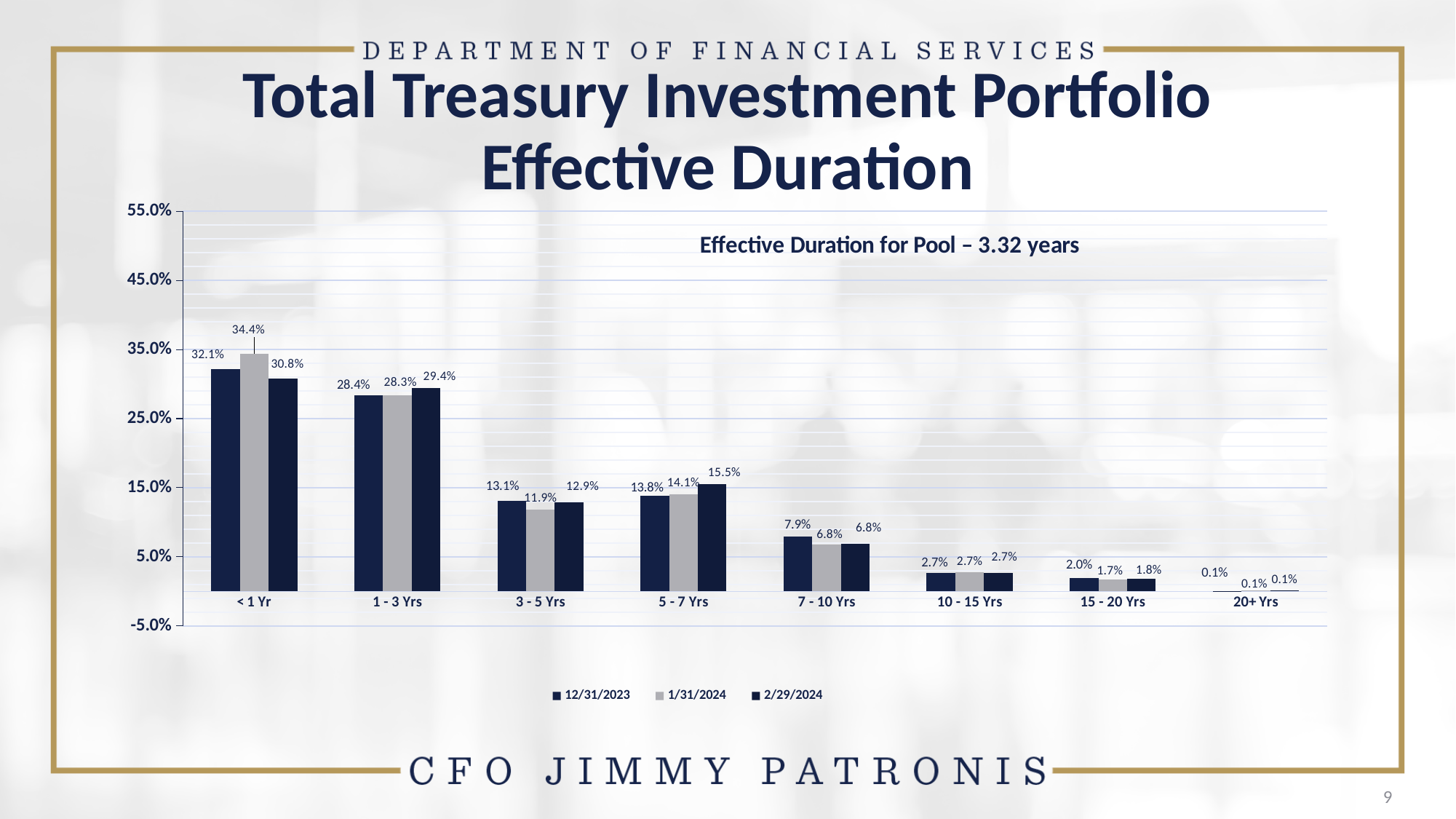
What effective duration for the pool is stated on the chart? 3.32 years What is the difference between the 1/31/2024 and 2/29/2024 values in the < 1 Yr category? 3.6% What is the value for the 2/29/2024 series in the 5 - 7 Yrs category? 15.5% Which category has the highest value for the 2/29/2024 series? < 1 Yr In the 3 - 5 Yrs category, which is larger: the 12/31/2023 value or the 1/31/2024 value? 12/31/2023 What is the value for the 12/31/2023 series in the 7 - 10 Yrs category? 7.9% What kind of chart is shown on the slide? Bar chart How many series does the legend list? 3 Which category has the lowest value for the 12/31/2023 series? 20+ Yrs How many maturity categories are shown on the x axis? 8 What is the value for the 1/31/2024 series in the < 1 Yr category? 34.4% Do the values for the 2/29/2024 series generally rise or fall moving from < 1 Yr to 20+ Yrs? Fall